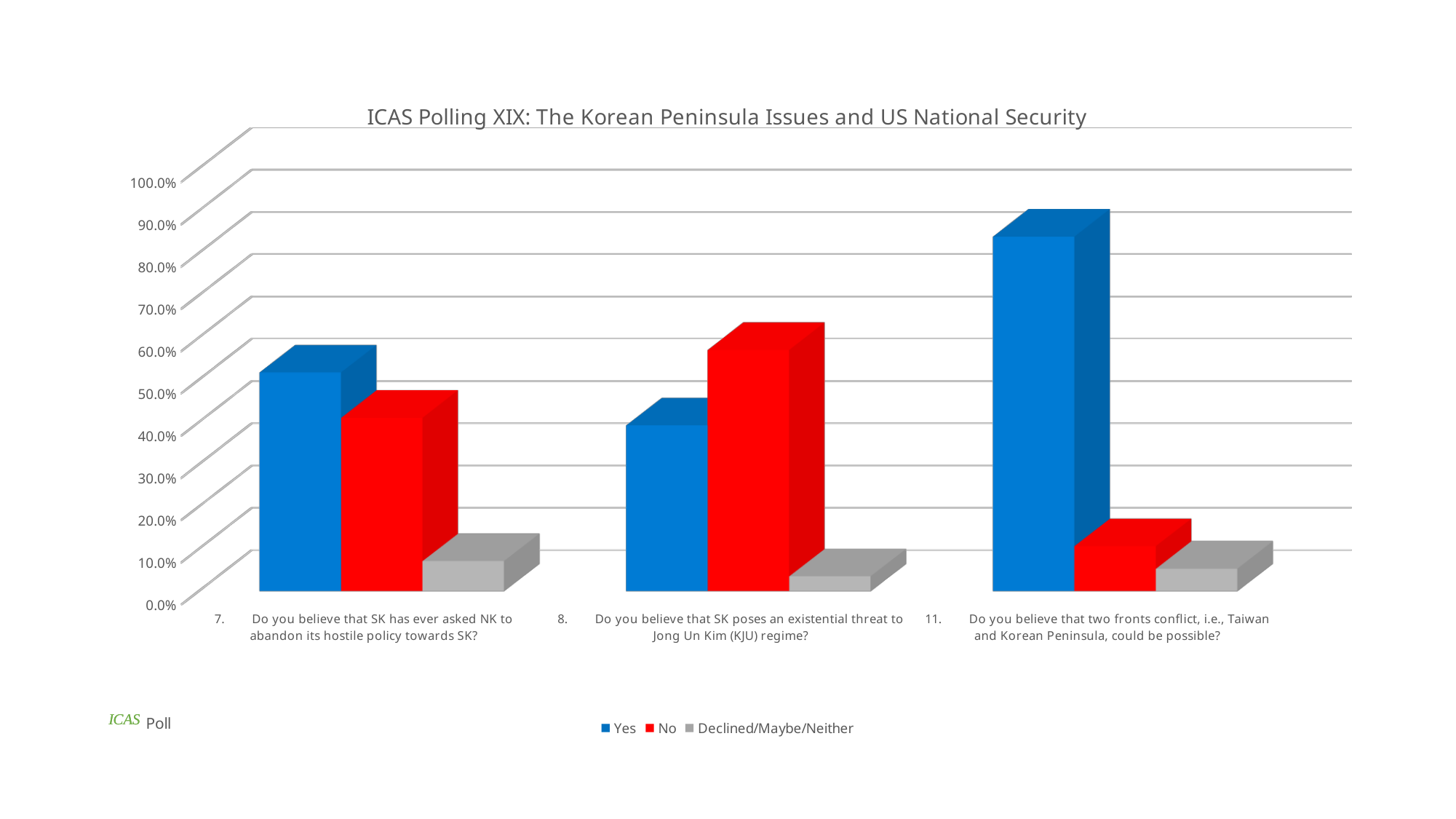
For which question is the Yes value highest? 11. Do you believe that two fronts conflict, i.e., Taiwan and Korean Peninsula, could be possible? How many series does the legend list? 3 Is the No value for question 8 greater or less than 50.0%? greater How many poll questions (categories) are plotted on the x axis? 3 Is the No value for question 11 greater or less than 20.0%? less What kind of chart is shown on the slide? bar chart Which series is shown in red in the legend? No Is the Yes value for question 8 greater or less than 50.0%? less What is the title of the chart? ICAS Polling XIX: The Korean Peninsula Issues and US National Security For question 8, which is larger, the Yes value or the No value? No For question 7, which is larger, the Yes value or the No value? Yes